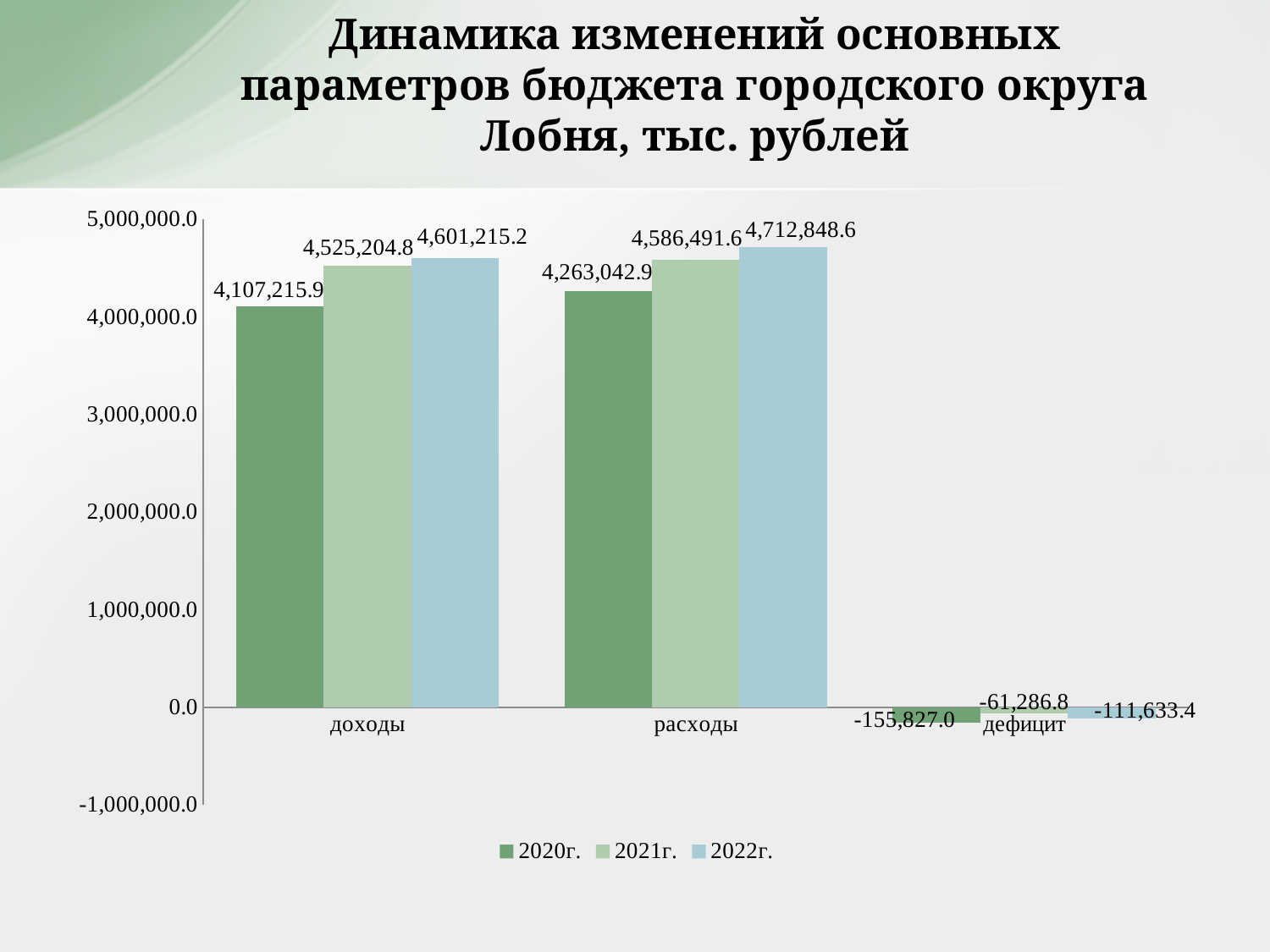
What is the value for расходы in 2022г.? 4,712,848.6 Which year has the lowest value for доходы? 2020г. What is the value for доходы in 2020г.? 4,107,215.9 Which is larger: расходы in 2020г. or доходы in 2021г.? доходы in 2021г. Which year has the highest value for расходы? 2022г. What is the difference between доходы in 2021г. and доходы in 2020г.? 417,988.9 How many series does the legend list? 3 What is the difference between расходы and доходы in 2022г.? 111,633.4 What kind of chart is shown on the slide? bar chart What is the value for дефицит in 2021г.? -61,286.8 What is the value for доходы in 2022г.? 4,601,215.2 How many categories are shown on the x axis? 3